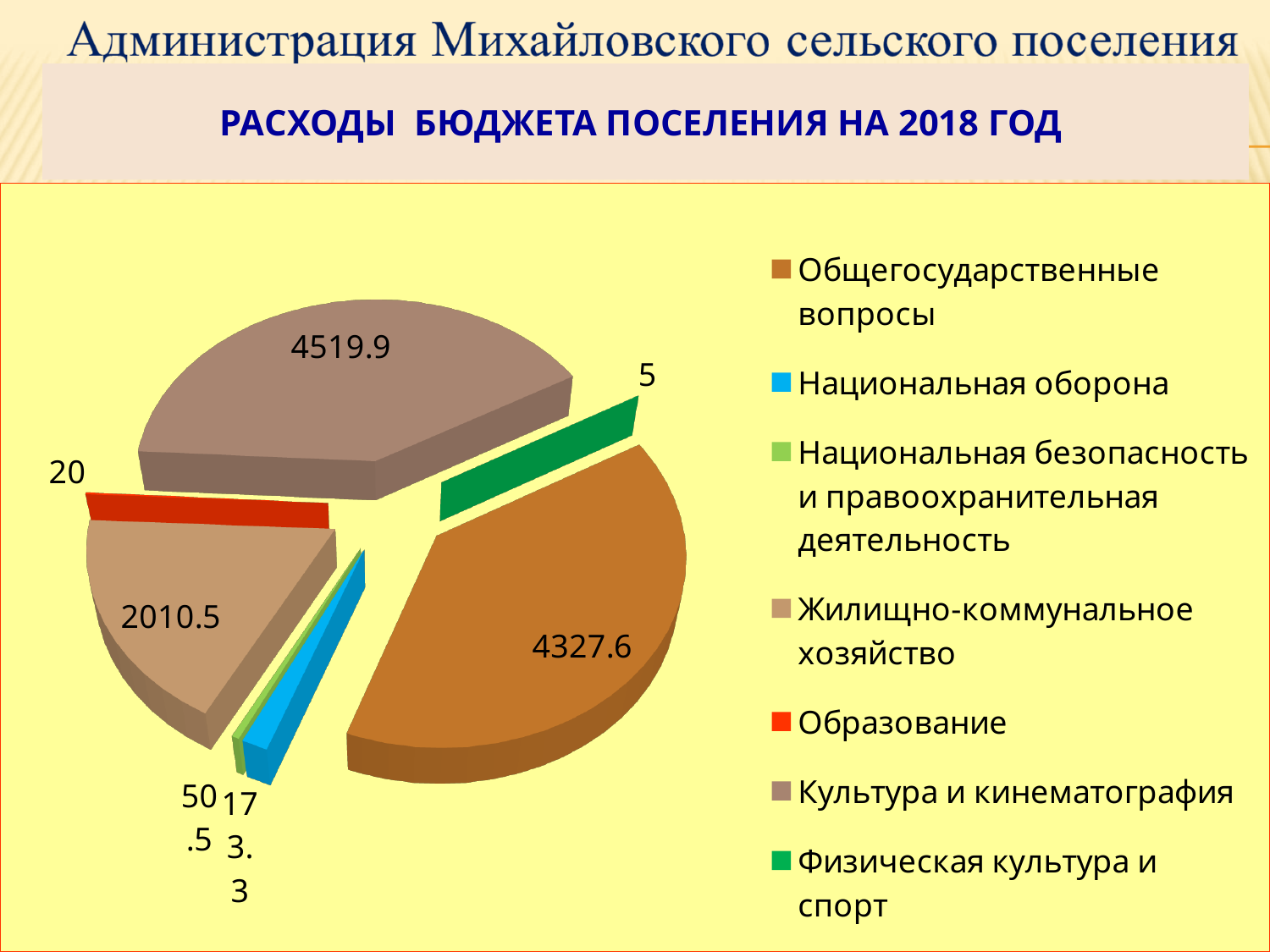
What is the title of the slide above the chart? РАСХОДЫ БЮДЖЕТА ПОСЕЛЕНИЯ НА 2018 ГОД What is the value for Культура и кинематография? 4519.9 What is the difference between the values for Культура и кинематография and Общегосударственные вопросы? 192.3 Which is larger: the value for Общегосударственные вопросы or the value for Жилищно-коммунальное хозяйство? Общегосударственные вопросы What type of chart is shown on the slide? Pie chart What is the value for Жилищно-коммунальное хозяйство? 2010.5 What is the value for Общегосударственные вопросы? 4327.6 Which category has the largest value? Культура и кинематография What is the value for Физическая культура и спорт? 5 How many categories does the legend list? 7 Which category has the smallest value? Физическая культура и спорт What is the value for Образование? 20